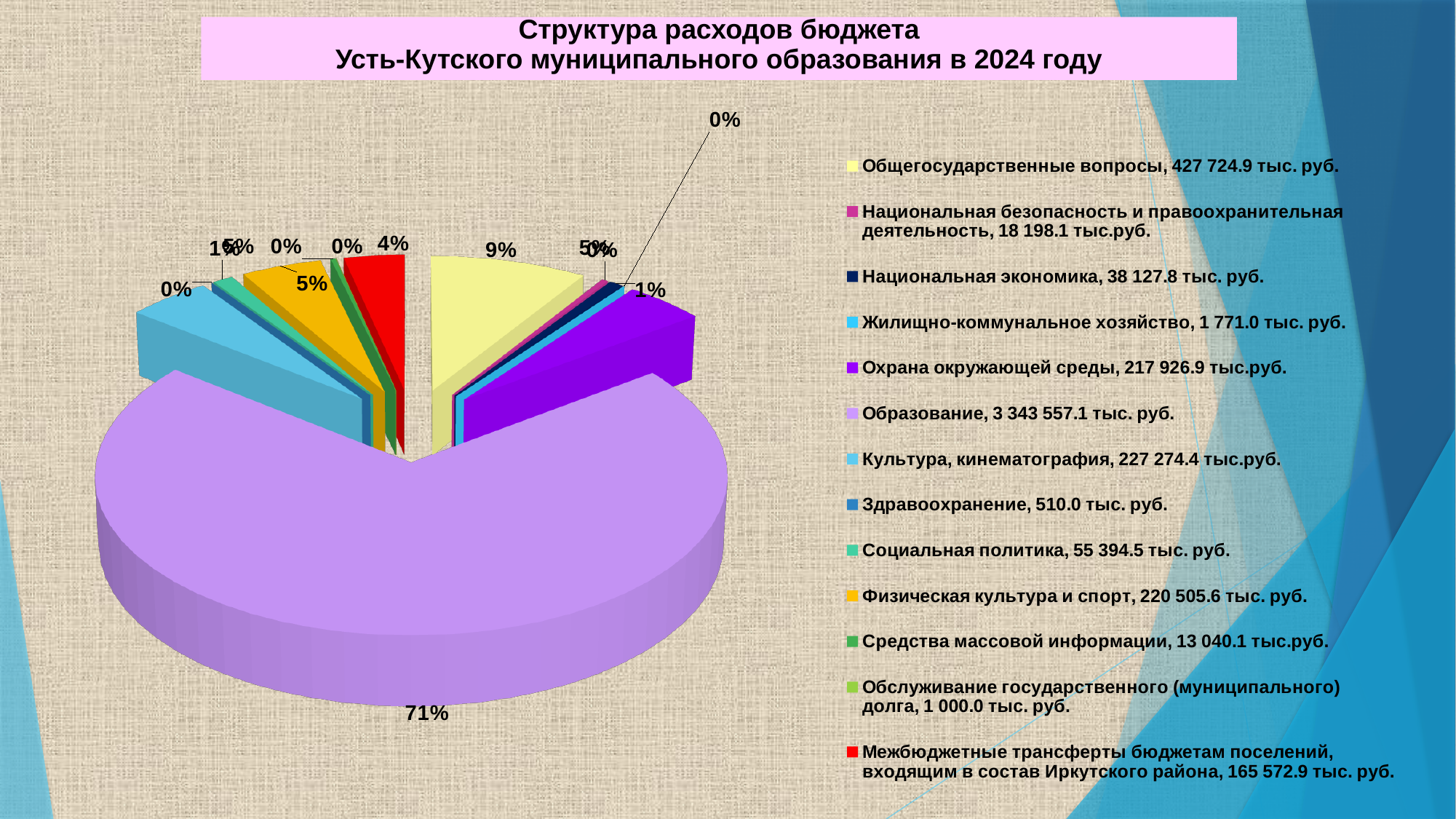
What is the difference between the expenditure for Культура, кинематография and Физическая культура и спорт? 6 768.8 тыс. руб. What share of the pie does Межбюджетные трансферты бюджетам поселений account for? 4% What is the expenditure value for Здравоохранение? 510.0 тыс. руб. What kind of chart is shown on the slide? pie chart What share of the pie does Общегосударственные вопросы account for? 9% Which category has the smallest expenditure value in the legend? Здравоохранение What is the expenditure value for Образование? 3 343 557.1 тыс. руб. How many categories does the legend of the pie chart list? 13 Which is larger: the expenditure for Культура, кинематография or for Физическая культура и спорт? Культура, кинематография Which category has the largest share of the budget expenditures? Образование What is the expenditure value for Охрана окружающей среды? 217 926.9 тыс.руб. What share of the pie does Образование account for? 71%